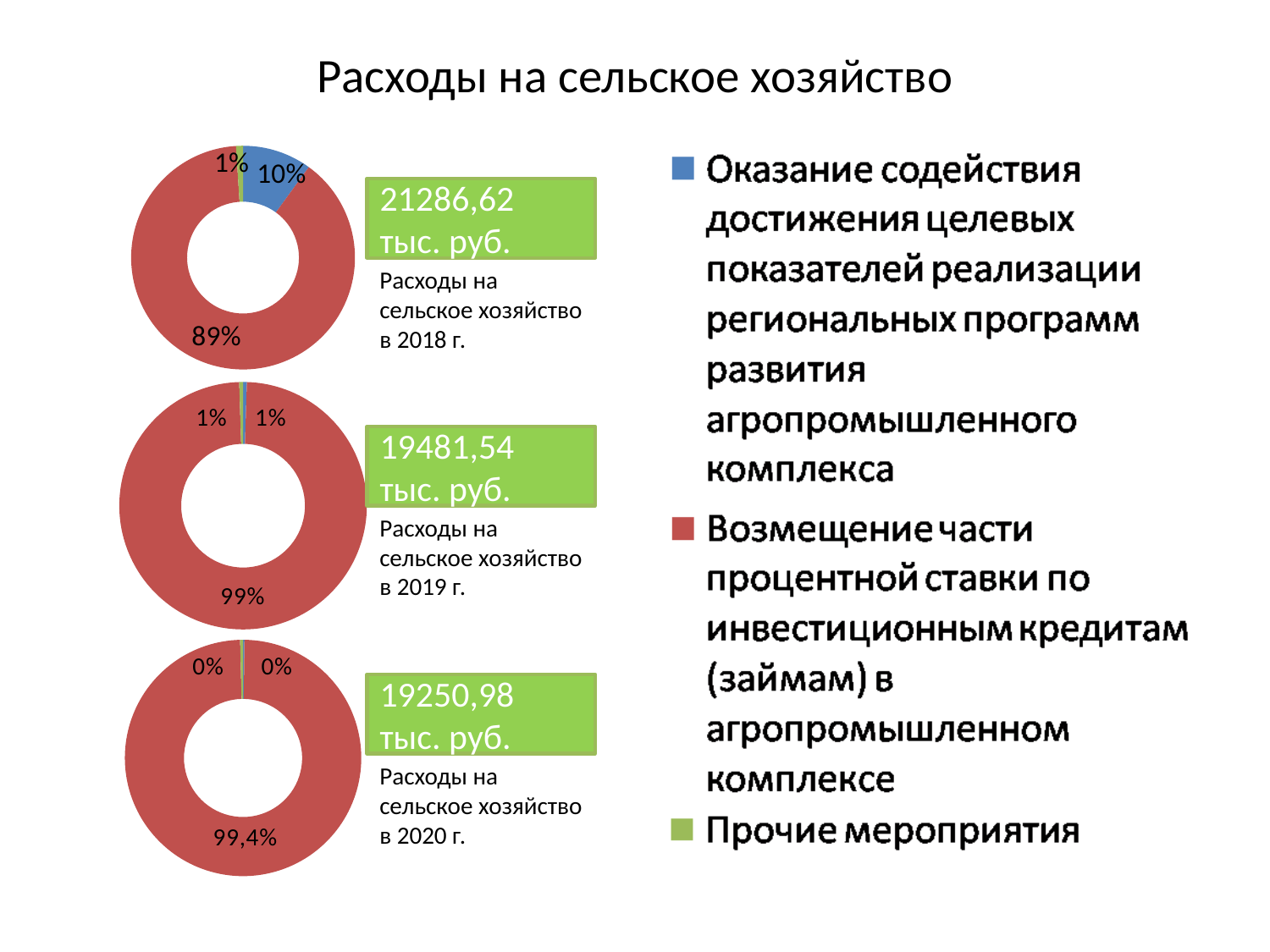
In the 2018 chart (top), what share is shown for 'Возмещение части процентной ставки по инвестиционным кредитам (займам) в агропромышленном комплексе'? 89% In the 2018 chart (top), what share is shown for 'Прочие мероприятия'? 1% In the 2020 chart (bottom), what share is shown for 'Возмещение части процентной ставки по инвестиционным кредитам (займам) в агропромышленном комплексе'? 99,4% In the 2018 chart (top), which category has the largest share? Возмещение части процентной ставки по инвестиционным кредитам (займам) в агропромышленном комплексе In the 2018 chart (top), which category has the smallest share? Прочие мероприятия How many categories does the legend list? 3 In the 2018 chart (top), what is the difference between the share for 'Возмещение части процентной ставки...' and the share for 'Оказание содействия...'? 79% What total expenditure is shown next to the 2019 chart (middle)? 19481,54 тыс. руб. What kind of charts are shown on the slide? Doughnut (pie) charts